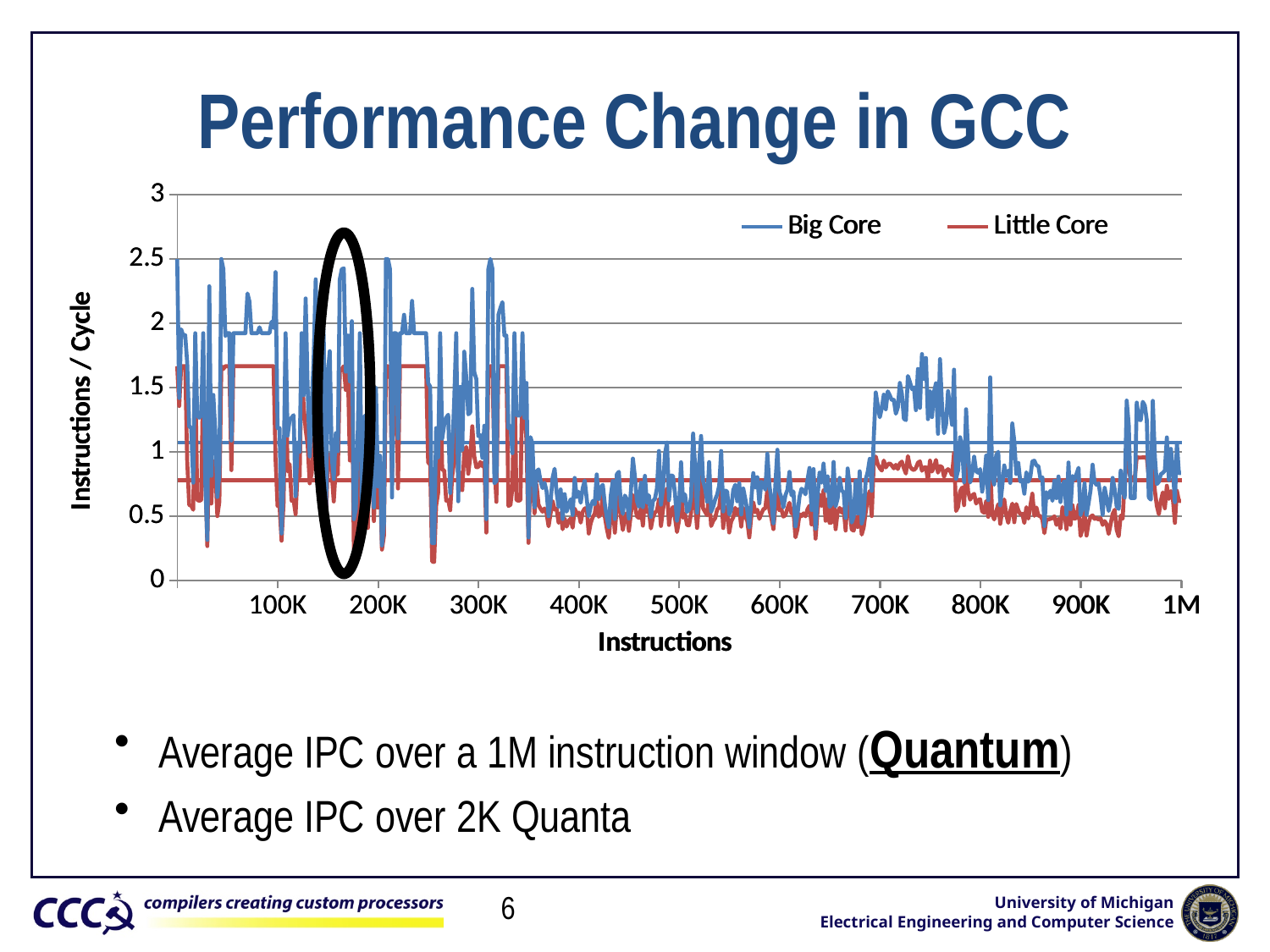
What is the label of the vertical axis? Instructions / Cycle Is the value for Big Core at around 450K instructions greater or less than 1.5? less How many series does the legend list? 2 What kind of chart is shown on the slide? Line chart Is the value for Little Core at around 500K instructions greater or less than 1? less Is the value for Little Core at around 250K instructions greater or less than 1? greater At around 100K instructions, which series has the higher value, Big Core or Little Core? Big Core At around 750K instructions, which series has the higher value, Big Core or Little Core? Big Core What is the title of the chart? Performance Change in GCC Which series generally has the higher Instructions / Cycle across the chart, Big Core or Little Core? Big Core